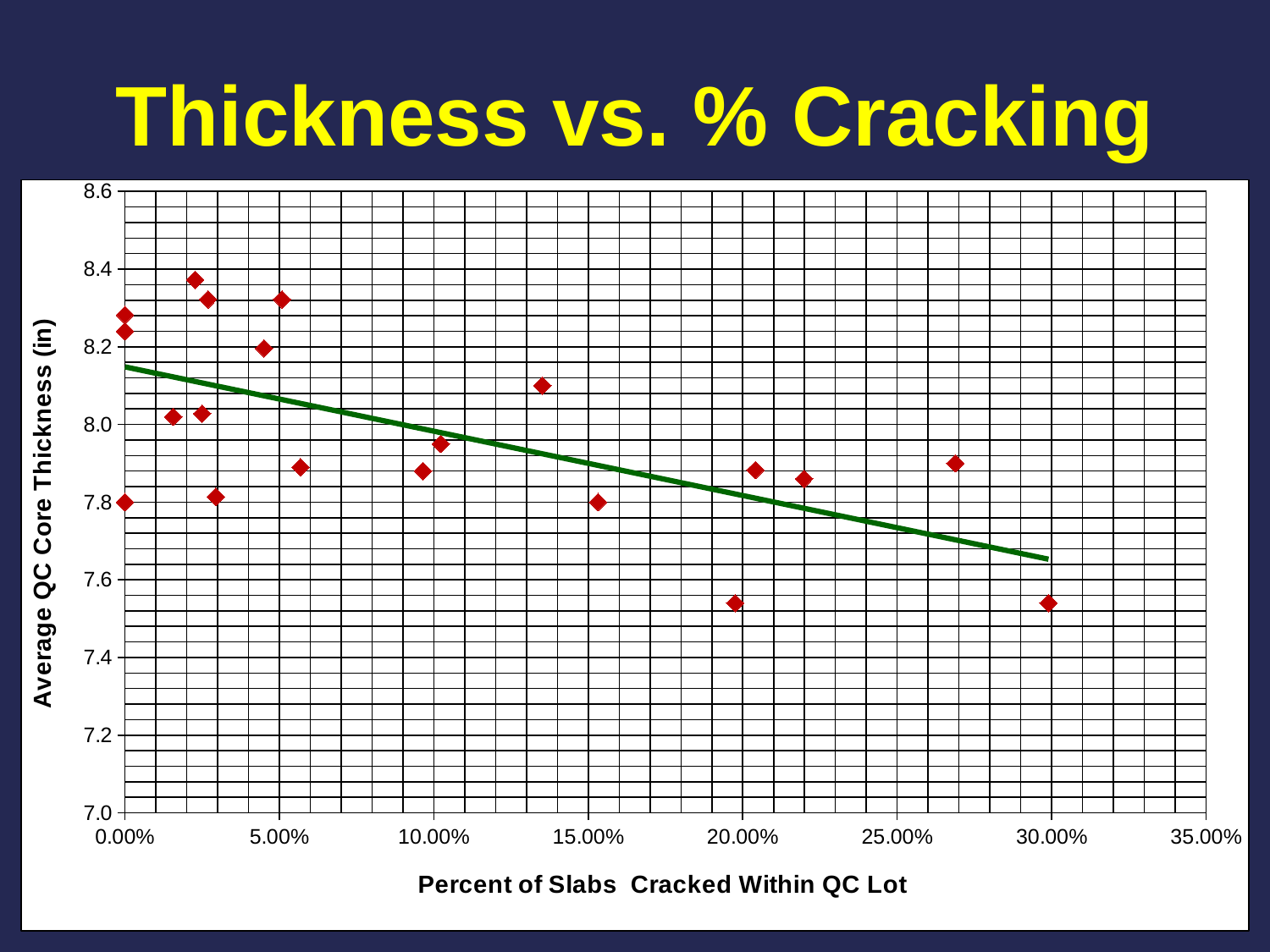
Is the highest plotted thickness value on the chart greater or less than 8.2? greater Is the lowest plotted thickness value on the chart greater or less than 7.6? less Is the average QC core thickness for the data point at about 30.00% cracking greater or less than 7.6? less What is the title of the chart's x axis? Percent of Slabs Cracked Within QC Lot What kind of chart is shown on the slide? scatter chart As the percent of slabs cracked increases along the x axis, does the trend line rise or fall? fall What is the title of the chart's y axis? Average QC Core Thickness (in)